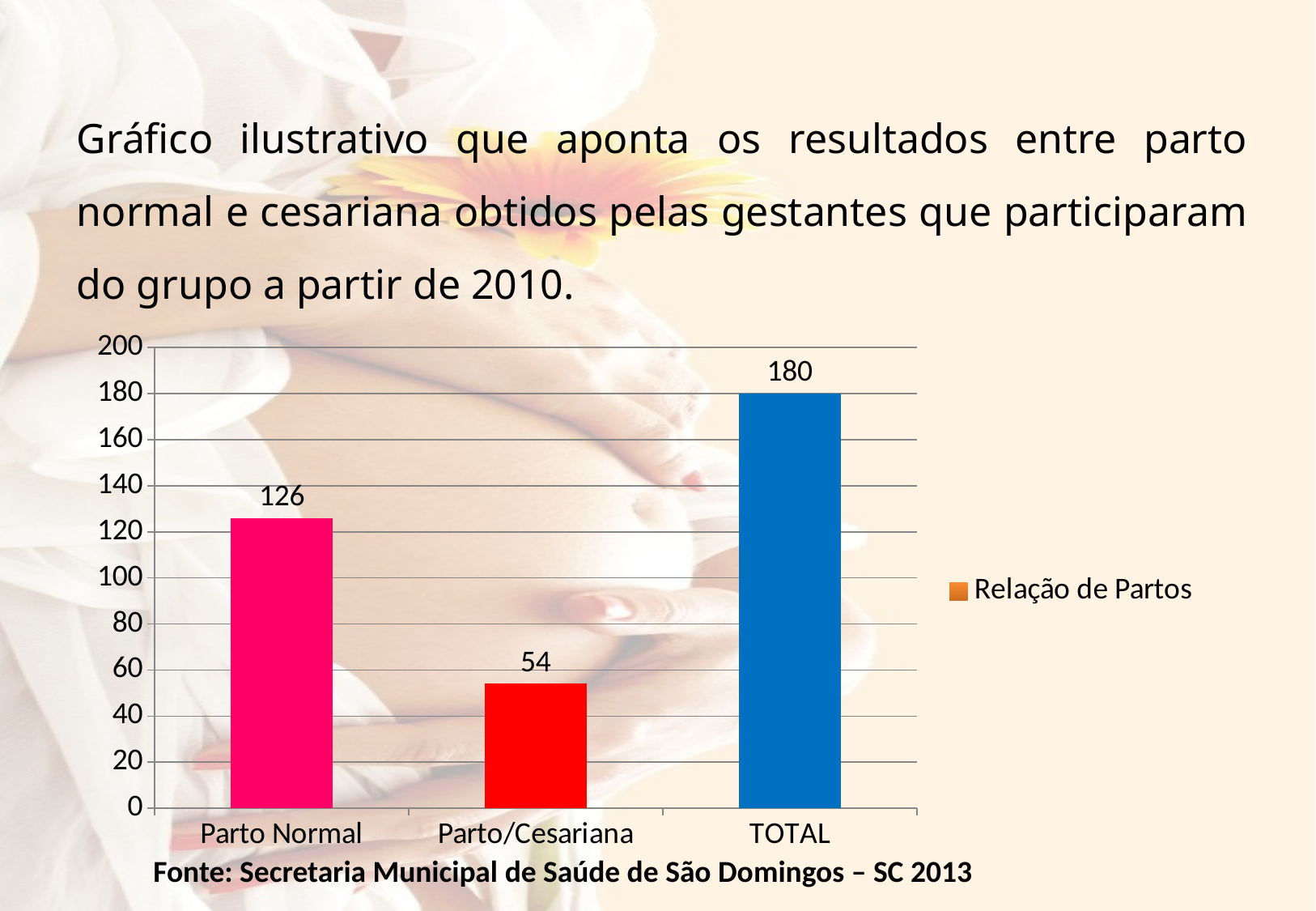
How many categories are shown on the x axis? 3 What is the difference between the values for Parto Normal and Parto/Cesariana? 72 Which category has the highest value? TOTAL Which is larger, the value for Parto Normal or the value for Parto/Cesariana? Parto Normal What kind of chart is shown on the slide? bar chart Is the value for Parto Normal greater or less than 100? greater How many series does the legend list? 1 What is the legend entry shown on the chart? Relação de Partos What is the value for TOTAL? 180 What is the value for Parto Normal? 126 Which category has the lowest value? Parto/Cesariana What is the value for Parto/Cesariana? 54